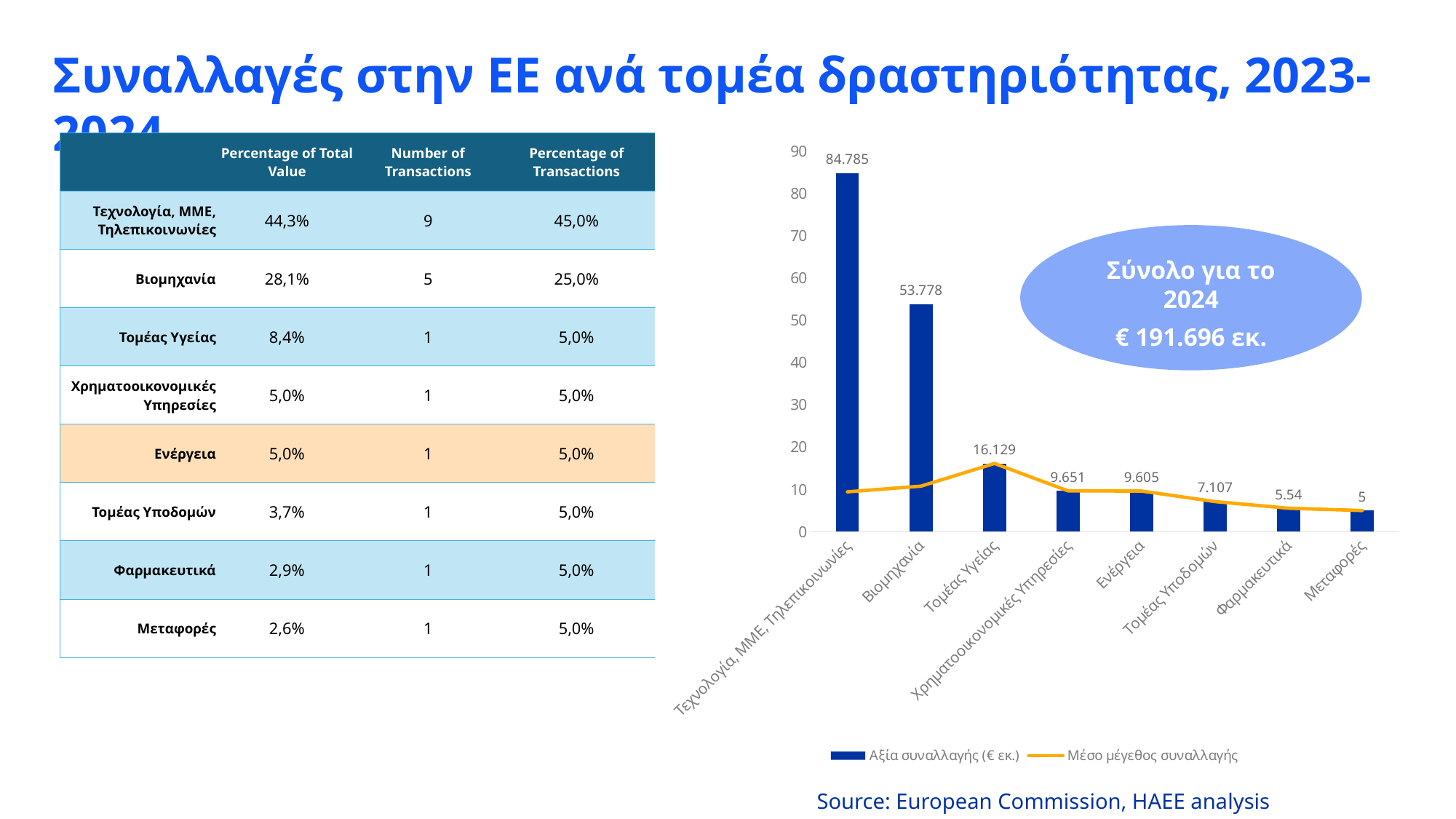
Which category has the highest Αξία συναλλαγής (€ εκ.)? Τεχνολογία, ΜΜΕ, Τηλεπικοινωνίες Which has a larger Αξία συναλλαγής (€ εκ.): Τομέας Υγείας or Φαρμακευτικά? Τομέας Υγείας Is the Αξία συναλλαγής (€ εκ.) for Βιομηχανία greater or less than 50? greater What is the value of Αξία συναλλαγής (€ εκ.) for Τεχνολογία, ΜΜΕ, Τηλεπικοινωνίες? 84.785 What is the value of Αξία συναλλαγής (€ εκ.) for Βιομηχανία? 53.778 How many categories are shown on the x axis of the chart? 8 What is the difference in Αξία συναλλαγής (€ εκ.) between Τεχνολογία, ΜΜΕ, Τηλεπικοινωνίες and Βιομηχανία? 31.007 What type of chart is shown on the right side of the slide? bar chart with a line What is the value of Αξία συναλλαγής (€ εκ.) for Ενέργεια? 9.605 How many series does the chart legend list? 2 Which category has the lowest Αξία συναλλαγής (€ εκ.)? Μεταφορές What is the value of Αξία συναλλαγής (€ εκ.) for Μεταφορές? 5